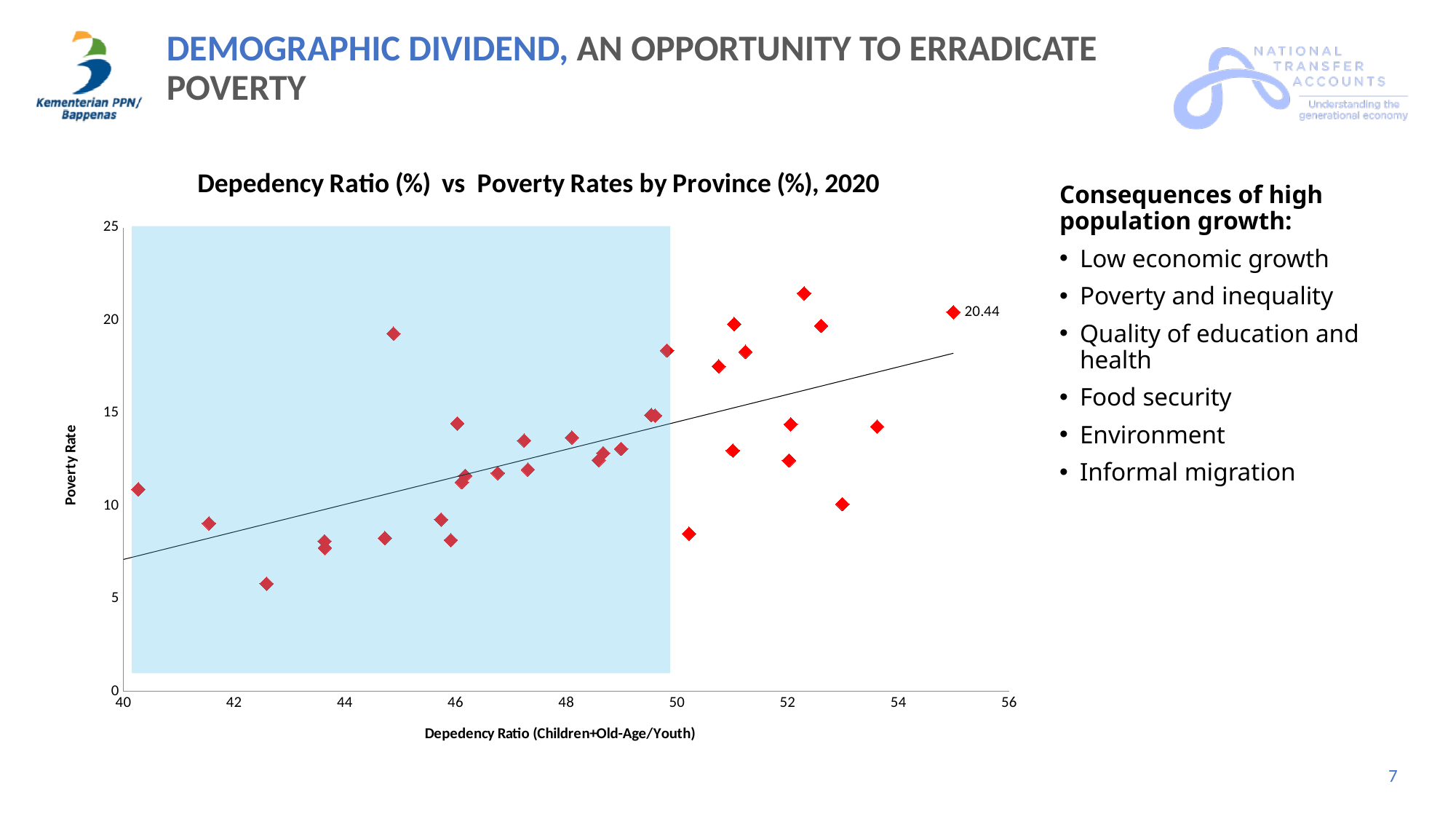
What poverty rate value is printed as a data label on the chart? 20.44 Is the highest poverty rate plotted on the chart greater or less than 20? greater Is the lowest poverty rate plotted on the chart greater or less than 10? less Is the poverty rate of the point with the lowest dependency ratio (around 40) greater or less than 15? less What is the maximum value shown on the x axis of the chart? 56 What kind of chart is shown on the slide? Scatter chart What is the title of the chart? Depedency Ratio (%) vs Poverty Rates by Province (%), 2020 What is the label of the vertical axis of the chart? Poverty Rate What is the poverty rate of the point with the highest dependency ratio (around 55)? 20.44 Do poverty rates generally rise or fall as the dependency ratio increases along the x axis, according to the trend line? Rise